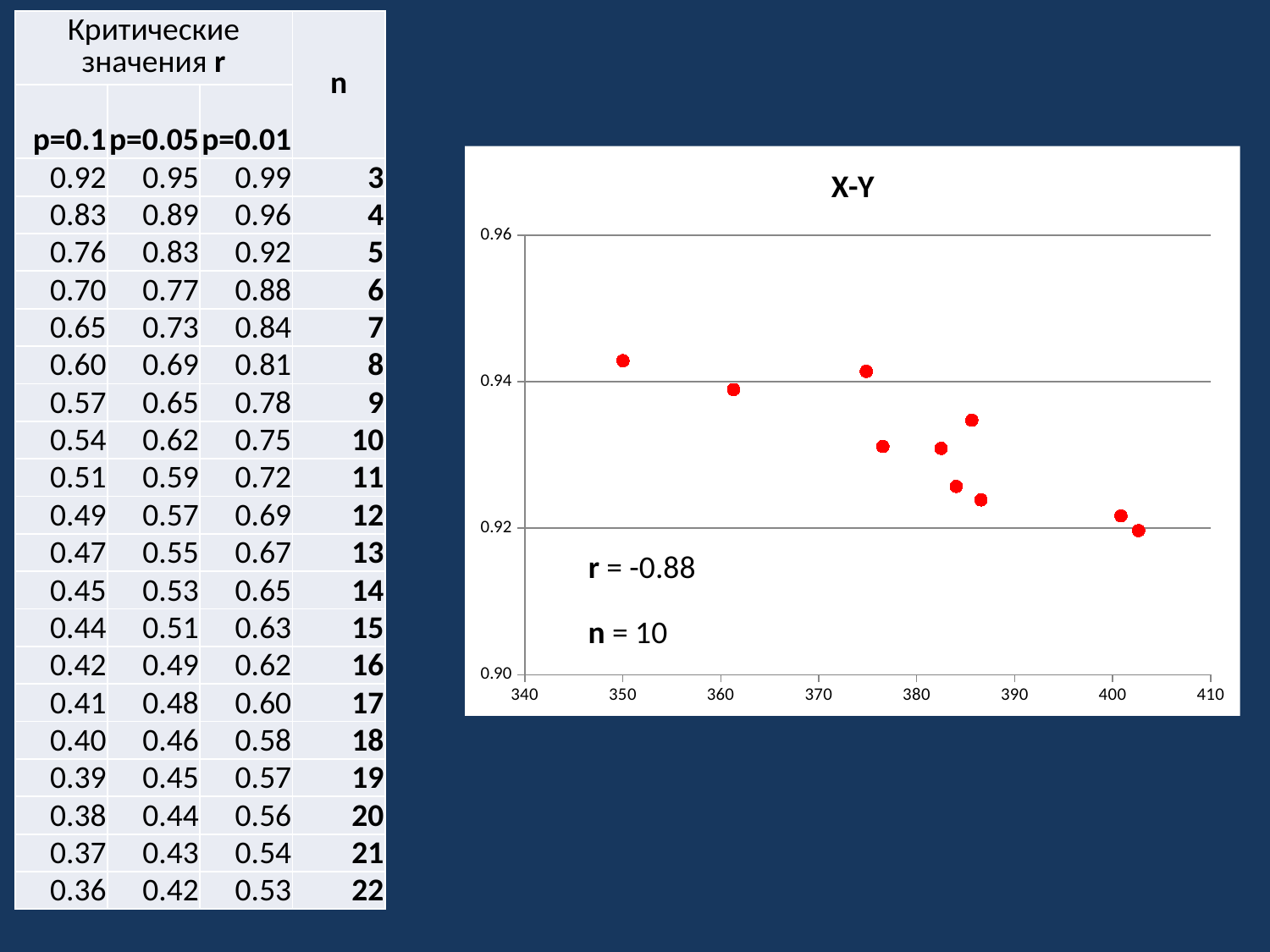
In the X-Y chart, is the y value of the point near x = 385 greater or less than 0.94? less What correlation coefficient r is printed on the X-Y chart? -0.88 In the X-Y chart, do the y values generally rise or fall as x increases? fall What kind of chart is shown on the slide? scatter chart In the X-Y chart, is the y value of the rightmost point (near x = 403) greater or less than 0.94? less In the X-Y chart, is the y value of the point near x = 386 greater or less than 0.92? greater What is the title of the chart? X-Y How many data points are plotted in the X-Y chart? 10 What is the lowest value shown on the y axis of the X-Y chart? 0.90 In the X-Y chart, which has the higher y value: the leftmost point or the rightmost point? the leftmost point What value of n is printed on the X-Y chart? 10